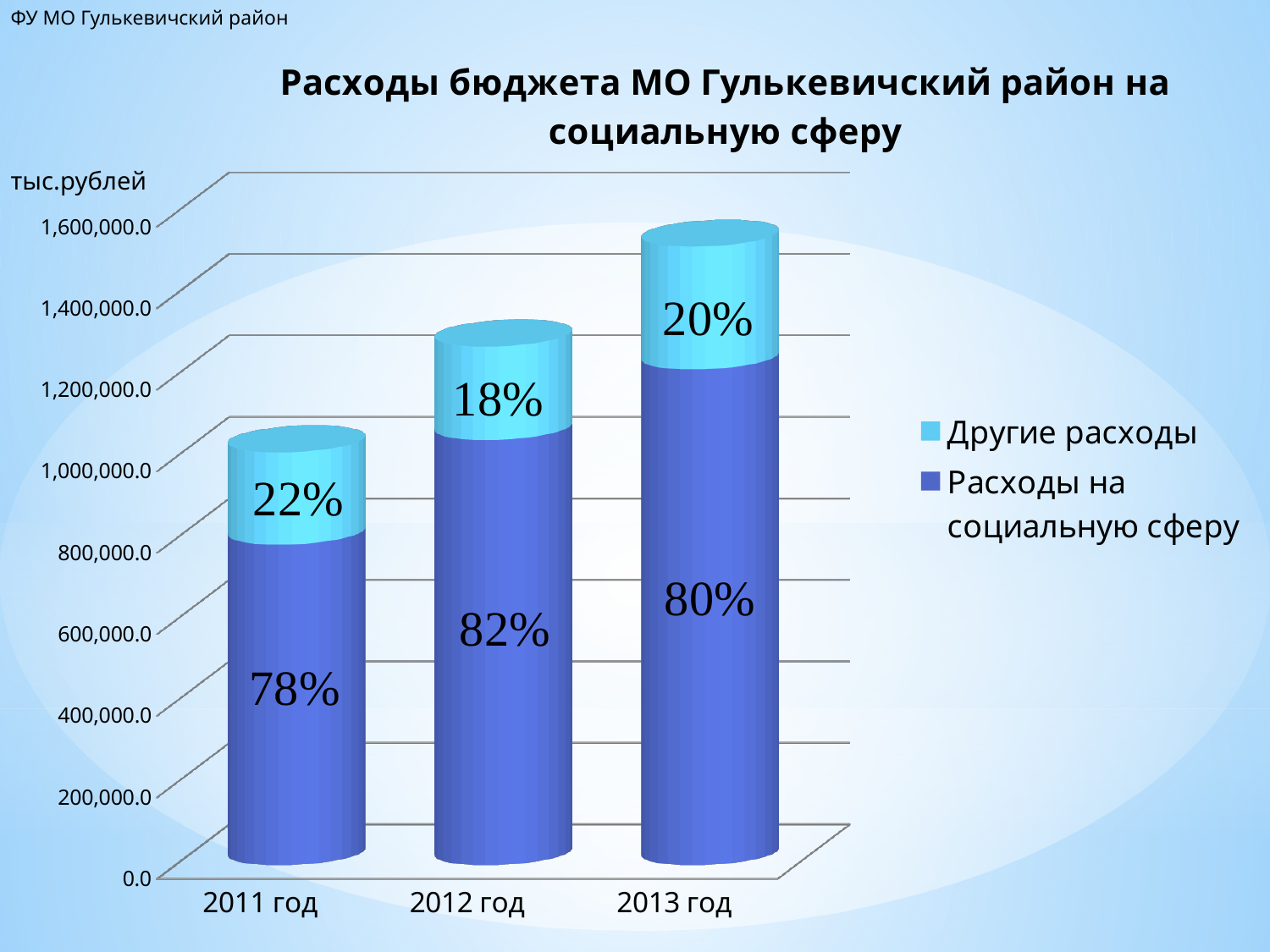
Which total bar is larger, 2011 год or 2013 год? 2013 год Which year has the tallest total bar? 2013 год What percentage label is shown for Расходы на социальную сферу in 2012 год? 82% Is the total bar for 2013 год greater or less than 1,200,000.0? greater How many series does the legend list? 2 What percentage label is shown for Расходы на социальную сферу in 2011 год? 78% In which year is the share of Расходы на социальную сферу the highest? 2012 год What percentage label is shown for Другие расходы in 2013 год? 20% How many years are shown on the x axis? 3 In which year is the share of Другие расходы the lowest? 2012 год What kind of chart is shown on the slide? Stacked bar chart Is the total bar for 2011 год greater or less than 1,400,000.0? less